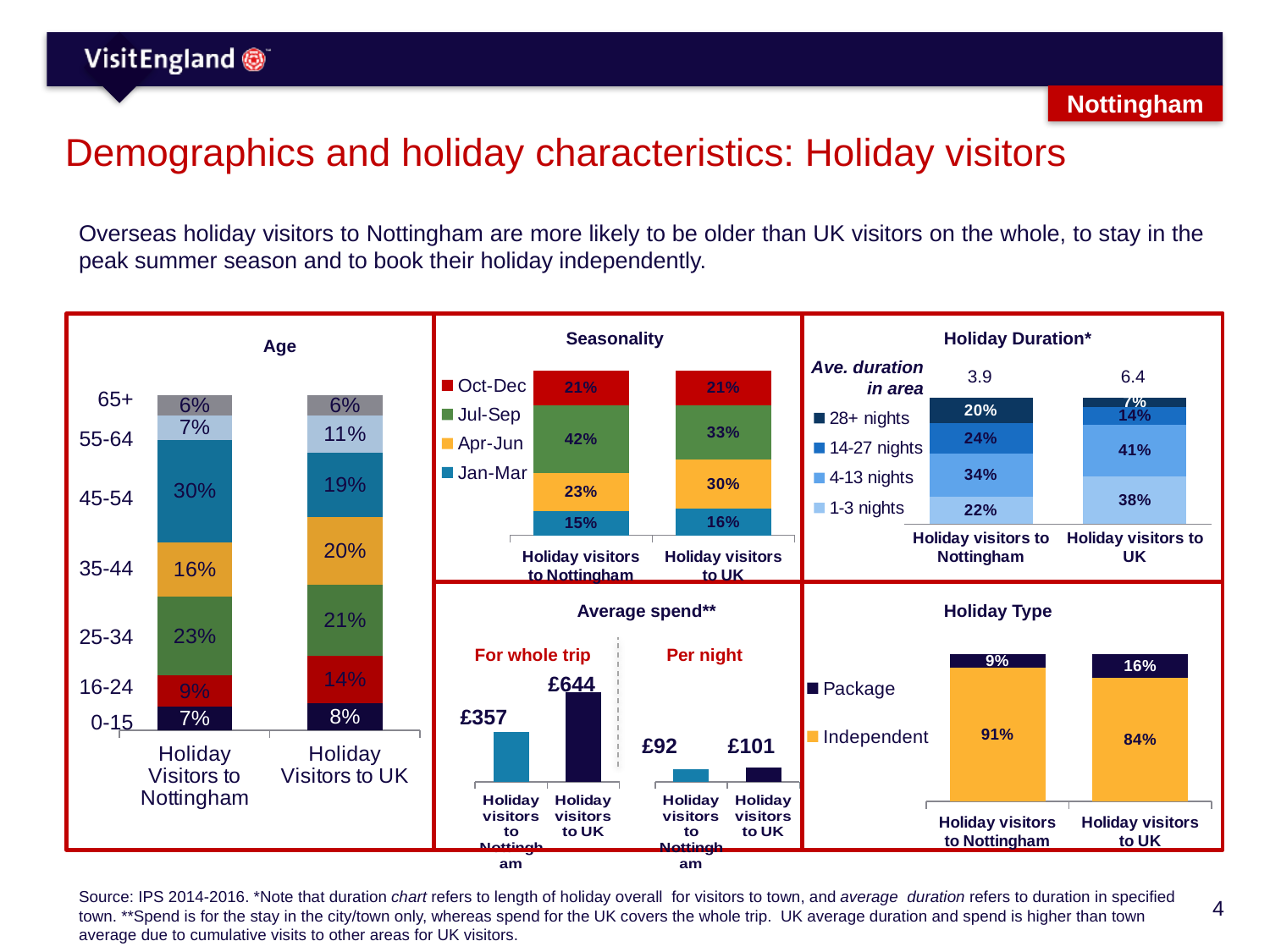
In the Age chart, what share of holiday visitors to Nottingham are aged 45-54? 30% In the Age chart, which age group is the largest for holiday visitors to UK? 25-34 In the Average spend chart, what is the average spend for the whole trip for holiday visitors to UK? £644 What kind of chart is the Holiday Type chart? Stacked bar chart In the Age chart, what is the difference between the 16-24 share for holiday visitors to UK and for holiday visitors to Nottingham? 5% In the Holiday Type chart, which group has the larger Package share, holiday visitors to Nottingham or holiday visitors to UK? Holiday visitors to UK In the Average spend chart, what is the difference in per night spend between holiday visitors to UK and holiday visitors to Nottingham? £9 In the Holiday Duration chart, what is the average duration in area shown for holiday visitors to Nottingham? 3.9 In the Seasonality chart, what share of holiday visitors to Nottingham visit in Jul-Sep? 42% In the Holiday Duration chart, what share of holiday visitors to UK stay 4-13 nights? 41% In the Seasonality chart, which quarter has the lowest share for holiday visitors to UK? Jan-Mar How many series does the legend of the Seasonality chart list? 4